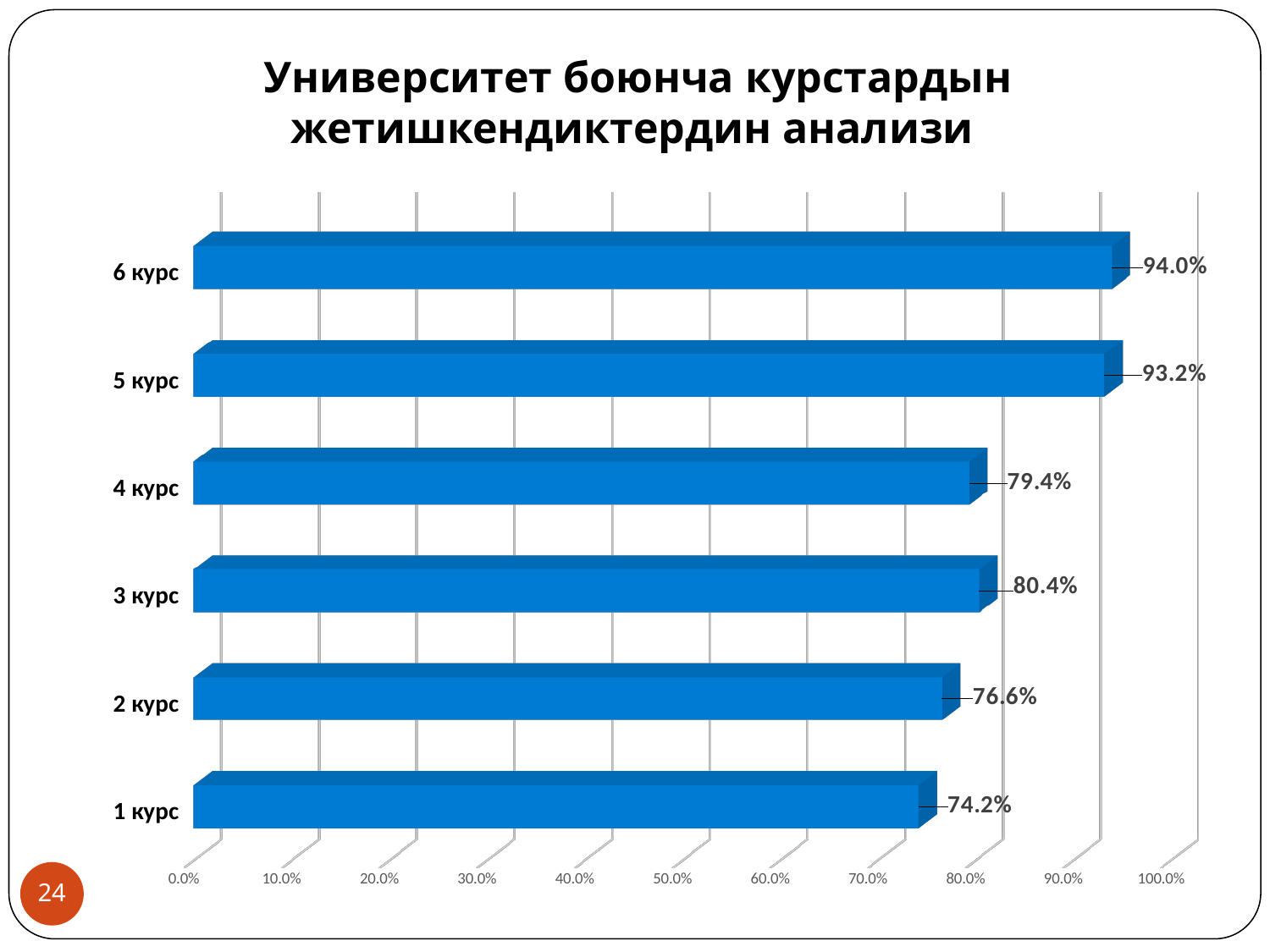
Is the value for 5 курс greater or less than 90.0%? greater What is the value for 6 курс? 94.0% What is the difference between the values for 3 курс and 4 курс? 1.0% Which course has the highest value? 6 курс Which course has the lowest value? 1 курс What kind of chart is shown on the slide? bar chart How many courses are shown in the chart? 6 What is the value for 1 курс? 74.2% Which is larger, the value for 2 курс or the value for 4 курс? 4 курс What is the value for 3 курс? 80.4% What is the title of the chart? Университет боюнча курстардын жетишкендиктердин анализи What is the difference between the values for 6 курс and 1 курс? 19.8%